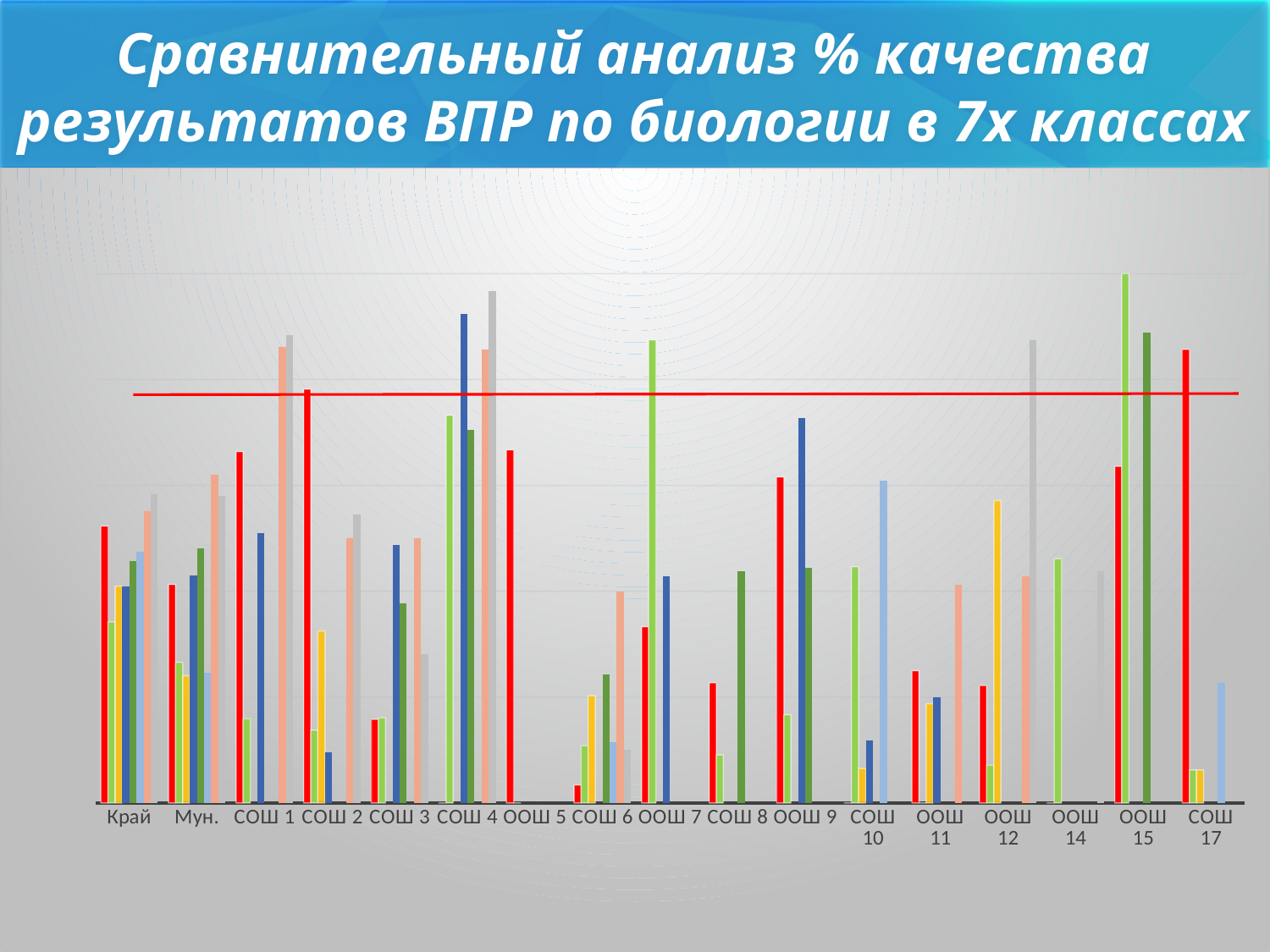
What colour is the horizontal reference line drawn across the chart? red Which has the taller red bar, Край or СОШ 1? СОШ 1 How many categories are shown along the x axis of the chart? 17 Which has the taller light green bar, ООШ 7 or СОШ 4? ООШ 7 Which has the taller dark blue bar, СОШ 4 or ООШ 9? СОШ 4 Which category contains the tallest bar in the chart? ООШ 15 What kind of chart is shown on the slide? bar chart What is the title of the slide's chart? Сравнительный анализ % качества результатов ВПР по биологии в 7х классах